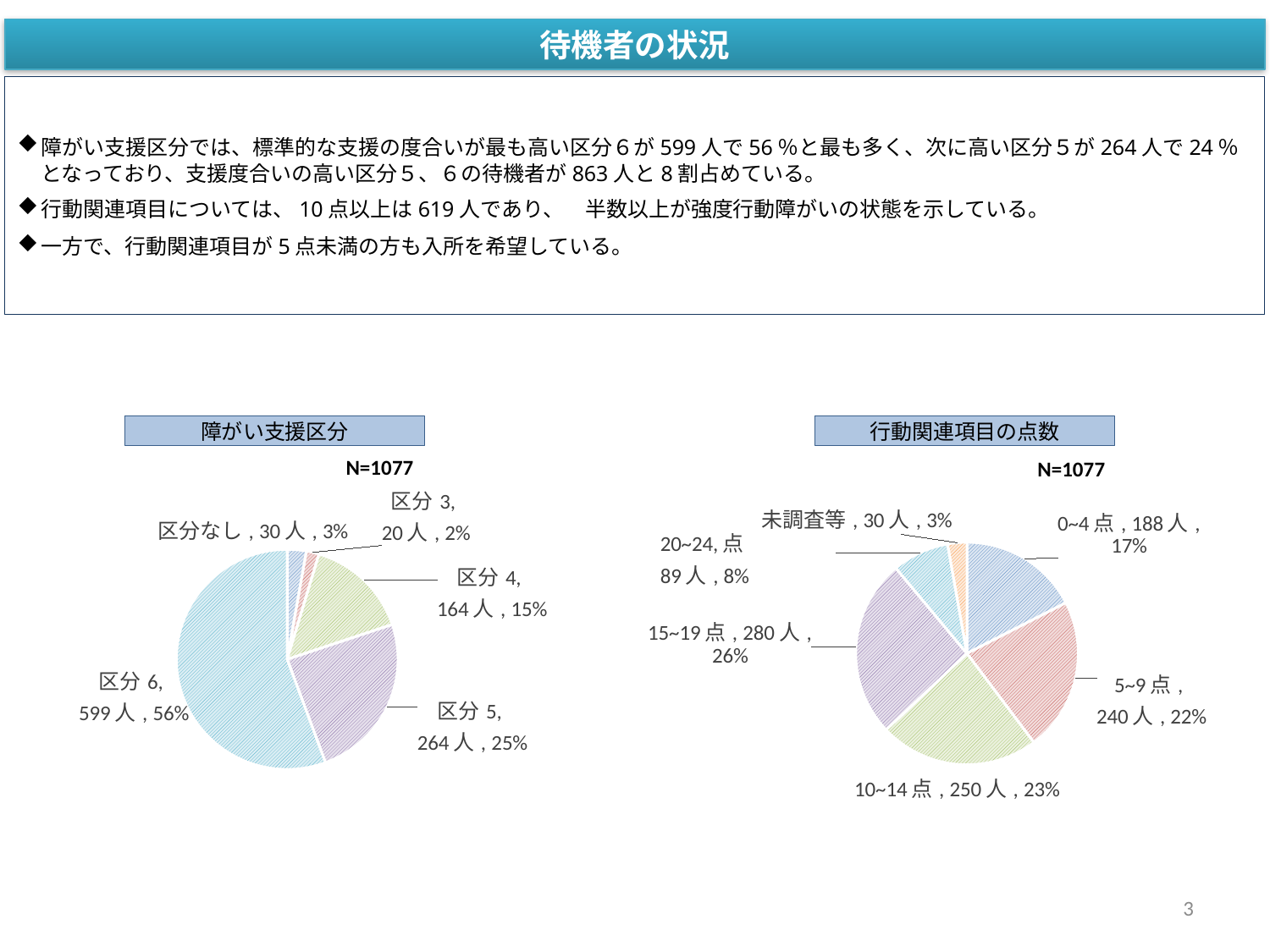
In the 行動関連項目の点数 chart, which category has the largest number of people? 15~19点 In the 障がい支援区分 chart, what share of the pie does 区分 5 represent? 25% In the 障がい支援区分 chart, how many categories are shown? 5 In the 行動関連項目の点数 chart, how many people scored 15~19点? 280人 In the 行動関連項目の点数 chart, which has more people: 10~14点 or 0~4点? 10~14点 In the 障がい支援区分 chart, which category has the smallest number of people? 区分 3 In the 行動関連項目の点数 chart, what is the difference in people between 20~24点 and 未調査等? 59人 In the 行動関連項目の点数 chart, what share of the pie does 5~9点 represent? 22% What type of chart is the 障がい支援区分 chart? Pie chart In the 障がい支援区分 chart, what is the difference in people between 区分 5 and 区分 4? 100人 What is the N value shown for the 行動関連項目の点数 chart? N=1077 In the 障がい支援区分 chart, how many people are in 区分 6? 599人